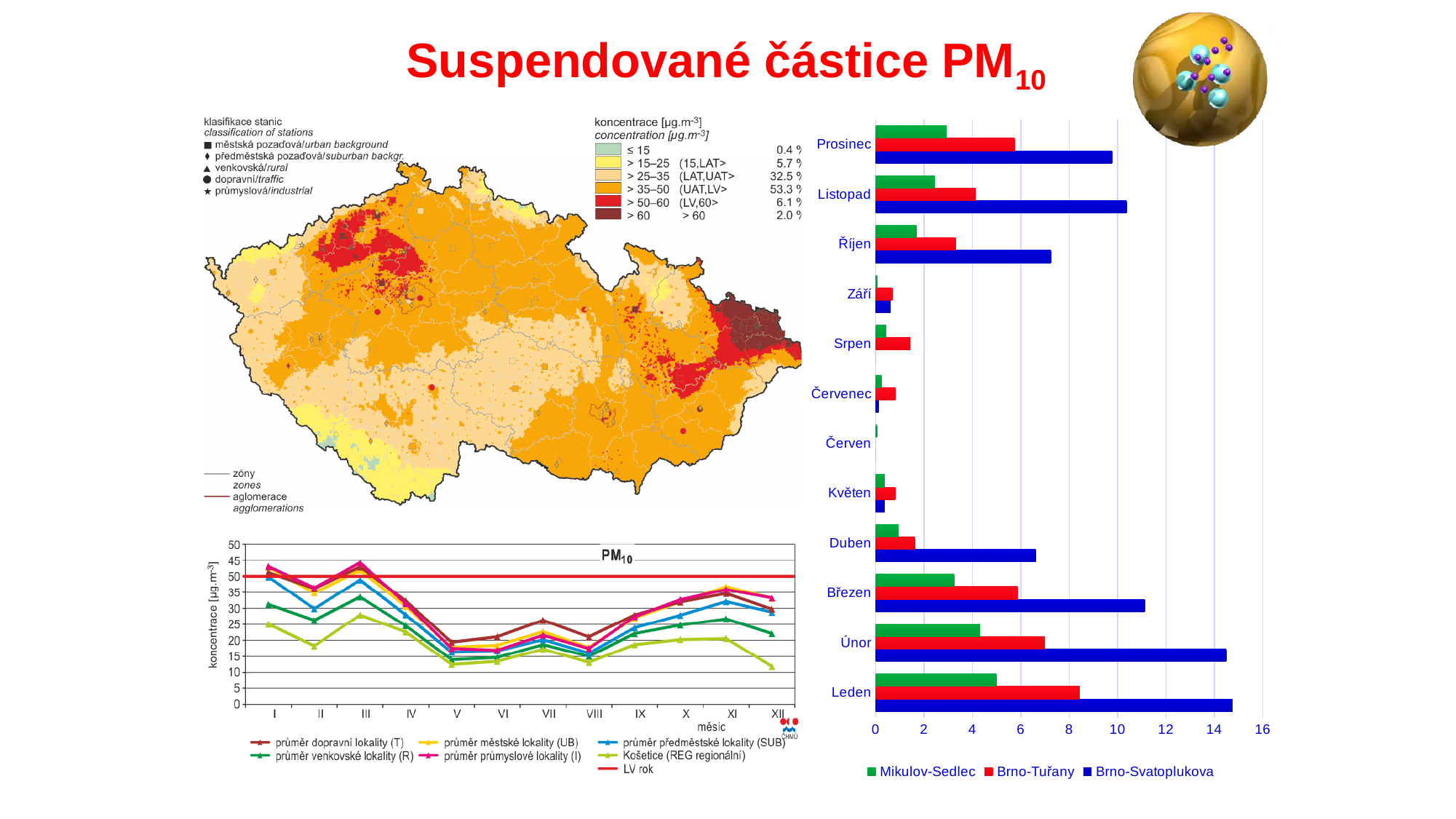
What kind of chart is the chart on the right side of the slide? bar chart In the bar chart on the right, is the value for Brno-Svatoplukova in Březen greater or less than 10? greater How many months (categories) are shown in the bar chart on the right? 12 In the line chart at the bottom left, is the Košetice (REG regionální) value in month XII greater or less than 15? less In the bar chart on the right, which is larger in Srpen: Brno-Tuřany or Brno-Svatoplukova? Brno-Tuřany In the bar chart on the right, in which month is the Mikulov-Sedlec value highest? Leden In the bar chart on the right, is the value for Mikulov-Sedlec in Leden greater or less than 6? less In the line chart at the bottom left, how many entries does the legend list? 7 How many series does the legend of the bar chart on the right list? 3 What kind of chart is the PM10 chart at the bottom left of the slide? line chart In the bar chart on the right, in which month is the Brno-Tuřany value highest? Leden